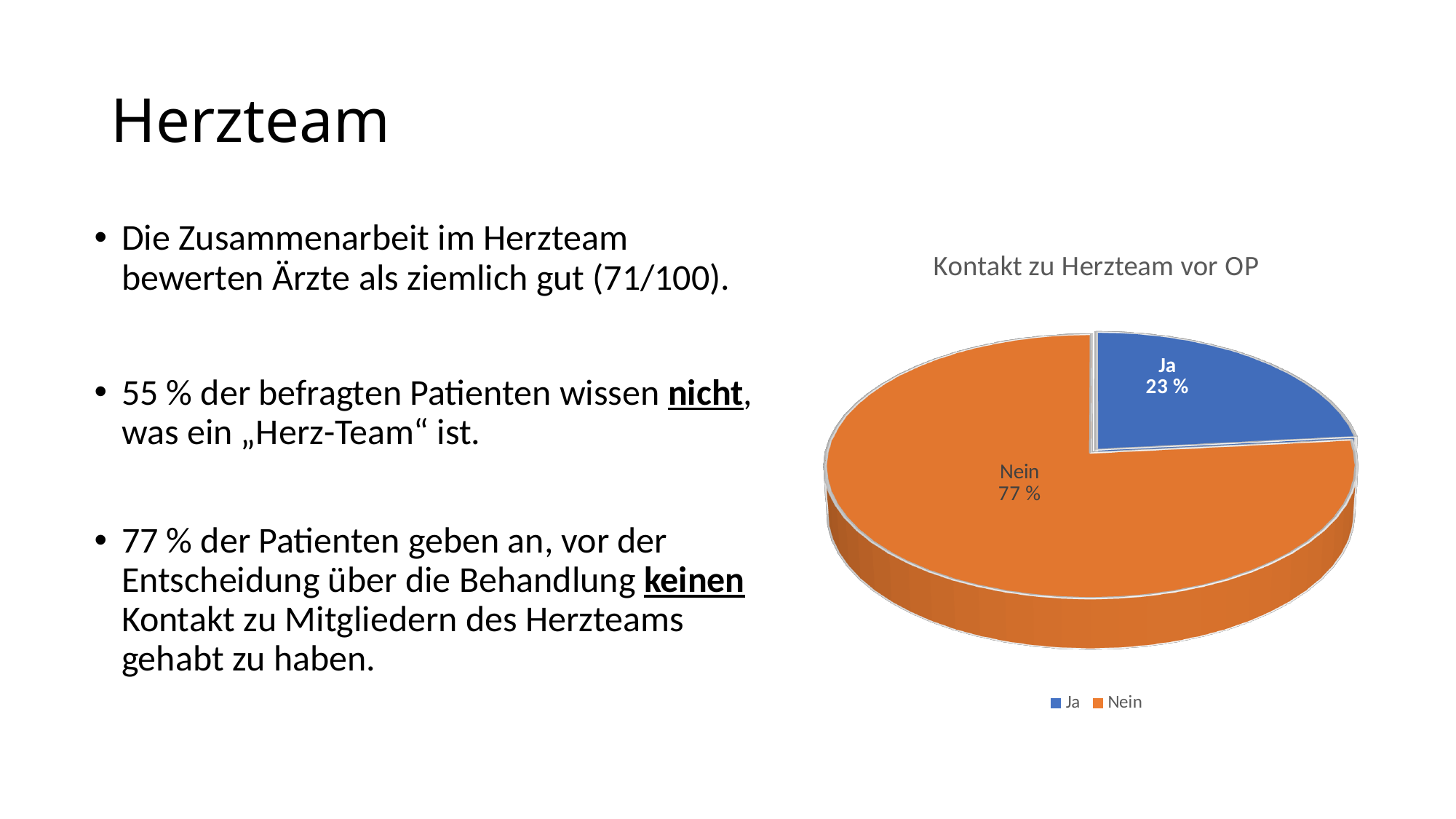
What share of the pie does the "Ja" slice represent? 23 % What is the difference in percentage points between the "Nein" and "Ja" slices? 54 % Which category has the smallest slice of the pie? Ja Which category has the largest slice of the pie? Nein How many categories does the pie chart show? 2 What kind of chart is shown on the slide? Pie chart Which is larger, the "Ja" slice or the "Nein" slice? Nein What is the value shown for "Ja"? 23 % What is the value shown for "Nein"? 77 % What share of the pie does the "Nein" slice represent? 77 % What is the title of the chart? Kontakt zu Herzteam vor OP Which colour represents the "Ja" category in the chart? Blue